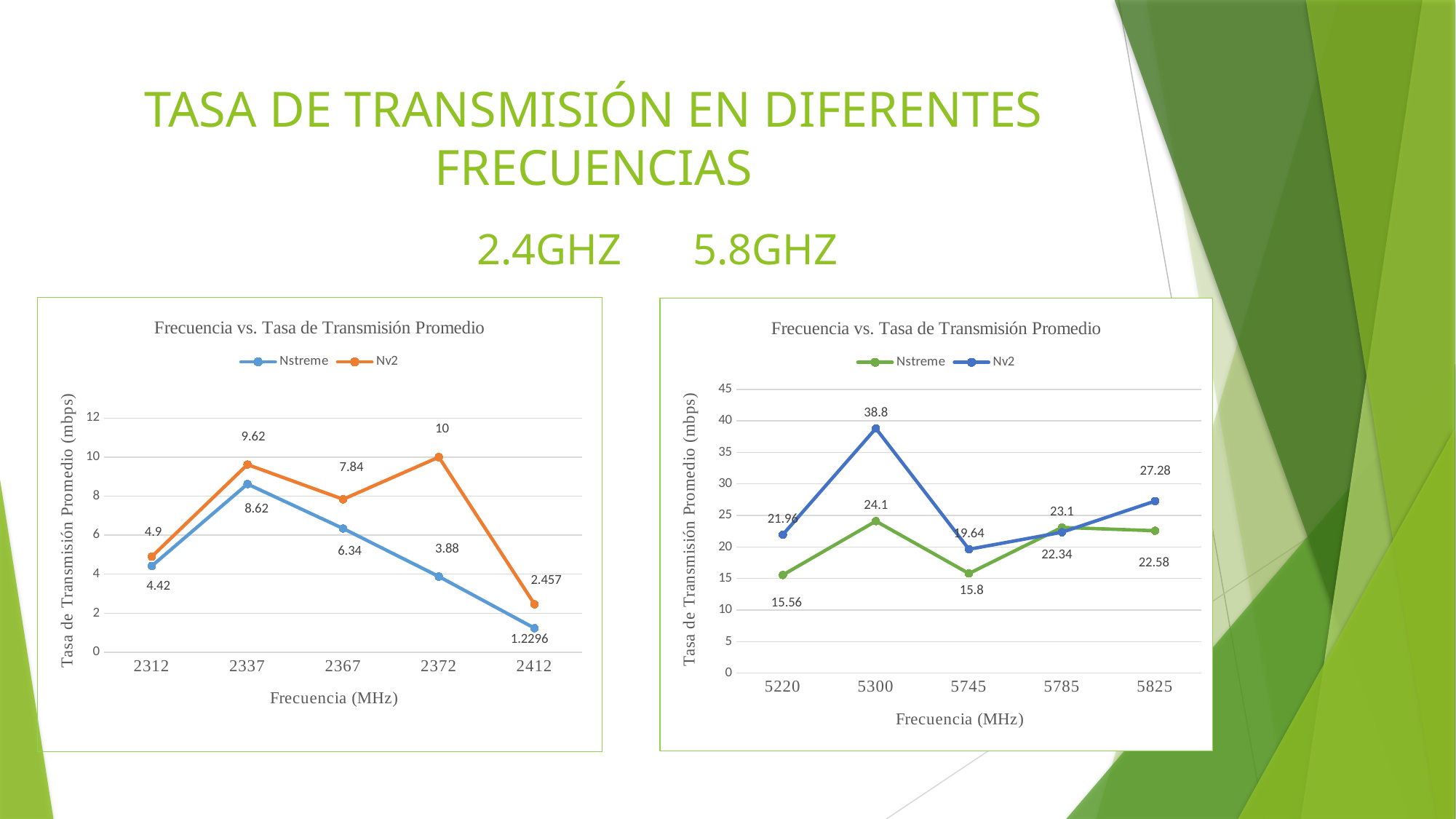
In the right chart (5.8GHz), what is the Nstreme value at 5220 MHz? 15.56 In the right chart (5.8GHz), what is the Nv2 value at 5300 MHz? 38.8 In the left chart (2.4GHz), at which frequency is the Nstreme value lowest? 2412 In the left chart (2.4GHz), at which frequency is the Nv2 value highest? 2372 In the right chart (5.8GHz), which series has the larger value at 5825 MHz, Nstreme or Nv2? Nv2 In the left chart (2.4GHz), what is the Nstreme value at 2412 MHz? 1.2296 In the left chart (2.4GHz), what is the Nv2 value at 2337 MHz? 9.62 How many frequency points are plotted on the x axis of the left chart (2.4GHz)? 5 What type of chart is the right chart (5.8GHz)? Line chart In the right chart (5.8GHz), what is the difference between the Nv2 and Nstreme values at 5300 MHz? 14.7 In the left chart (2.4GHz), what is the difference between the Nv2 and Nstreme values at 2367 MHz? 1.5 In the right chart (5.8GHz), at which frequency is the Nstreme value lowest? 5220